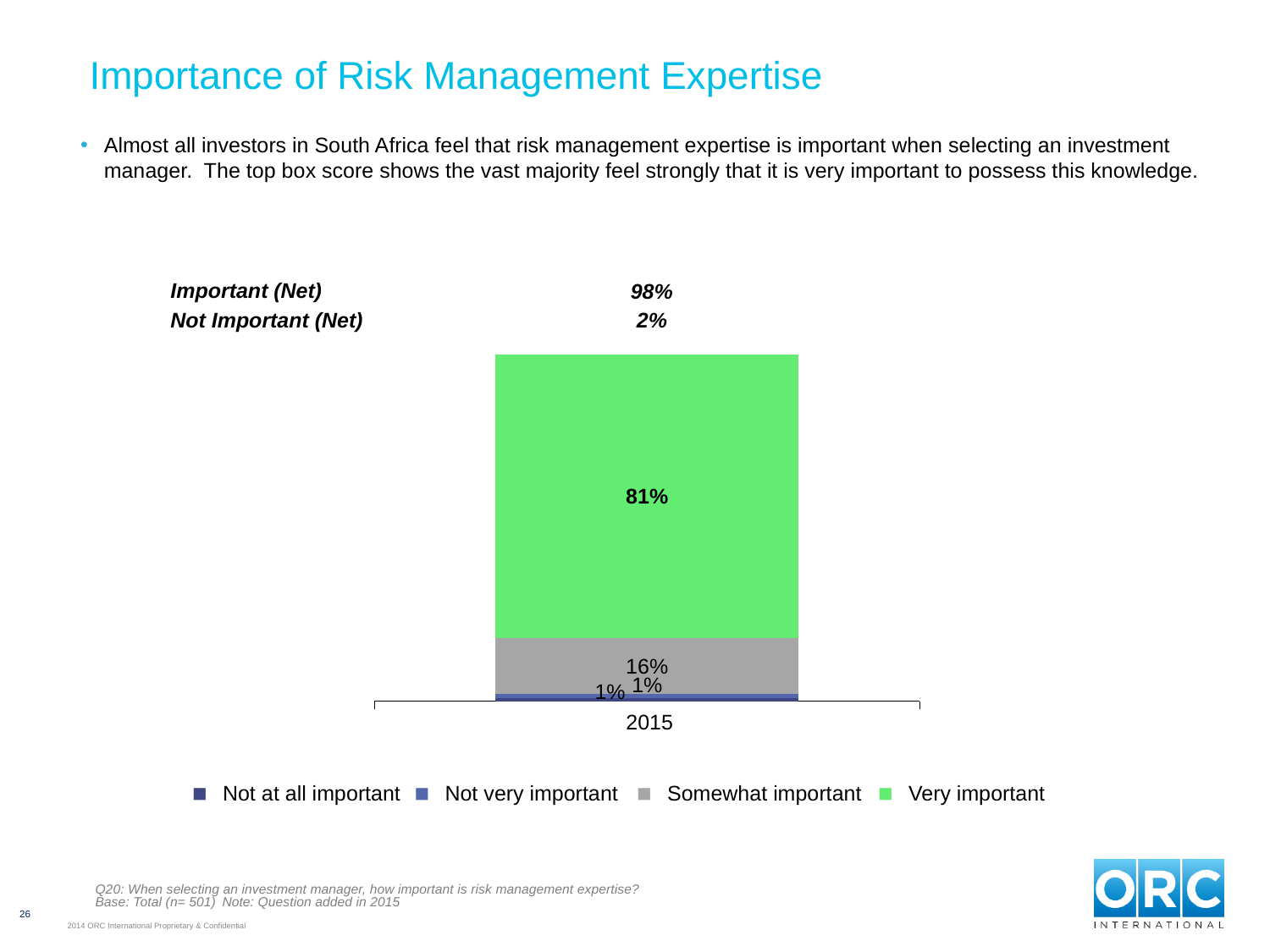
How many years (categories) are shown on the x axis? 1 How many series does the legend list? 4 What percentage of respondents said risk management expertise is somewhat important in 2015? 16% What is the Important (Net) value shown above the chart? 98% What is the difference between the 'Very important' and 'Somewhat important' percentages in 2015? 65 percentage points Which colour represents 'Very important' in the legend? Green What kind of chart is shown on the slide? Stacked bar chart Which is larger in 2015: the 'Somewhat important' share or the 'Not very important' share? Somewhat important Which response category has the largest share of the 2015 bar? Very important What is the Not Important (Net) value shown above the chart? 2% What percentage of respondents said risk management expertise is very important in 2015? 81% What percentage of respondents said risk management expertise is not very important in 2015? 1%